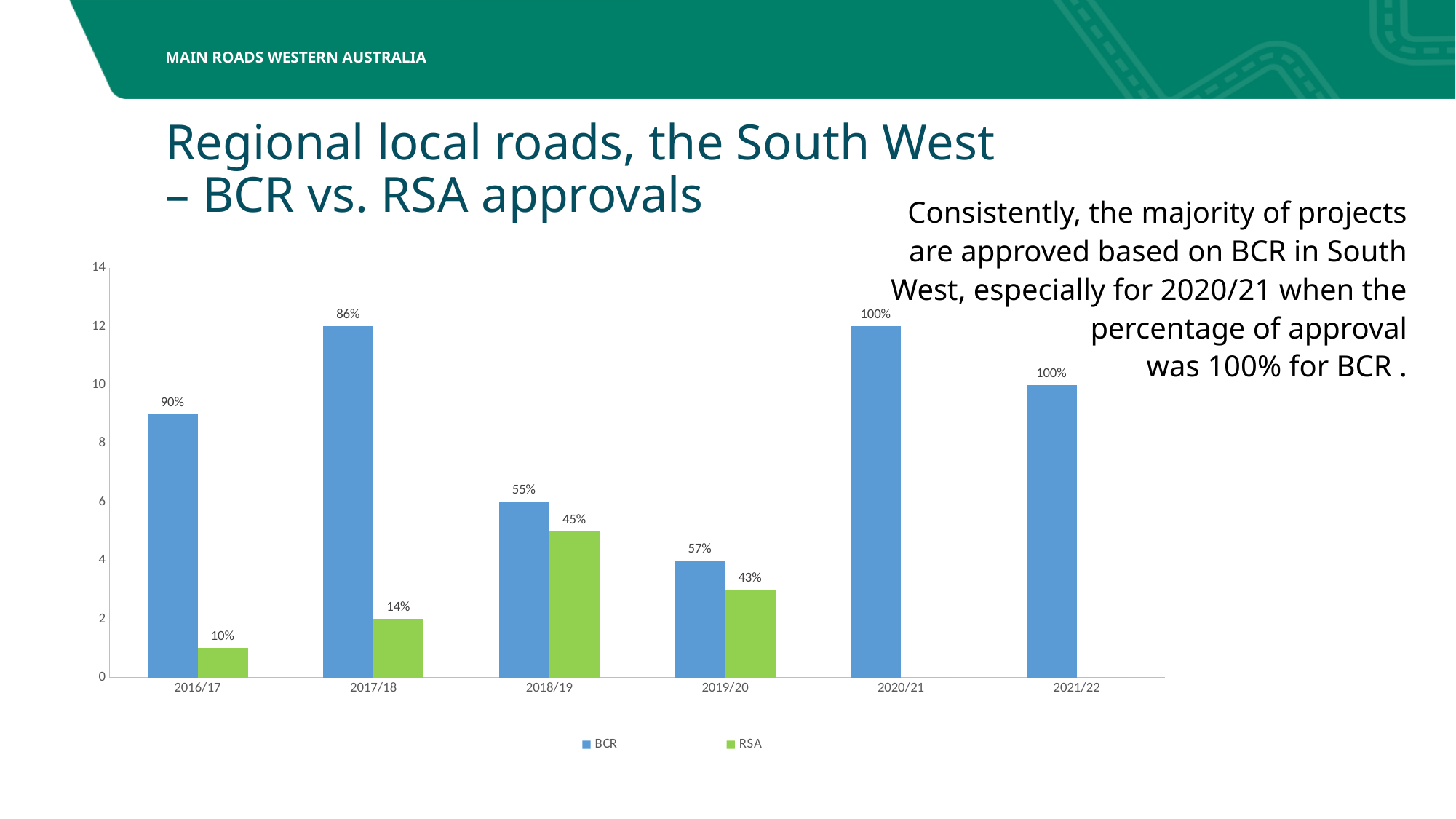
Which year has the lowest BCR bar? 2019/20 Which bar is taller in 2019/20, BCR or RSA? BCR Do the RSA bars rise or fall from 2016/17 to 2018/19? rise What percentage label is shown on the BCR bar for 2020/21? 100% Which year has the tallest RSA bar? 2018/19 Is the BCR bar for 2016/17 greater or less than 8 on the y axis? greater How many series does the legend list? 2 What kind of chart is shown on the slide? bar chart What percentage label is shown on the RSA bar for 2018/19? 45% How many financial-year categories are shown on the x axis? 6 What percentage label is shown on the BCR bar for 2017/18? 86% What percentage label is shown on the RSA bar for 2016/17? 10%